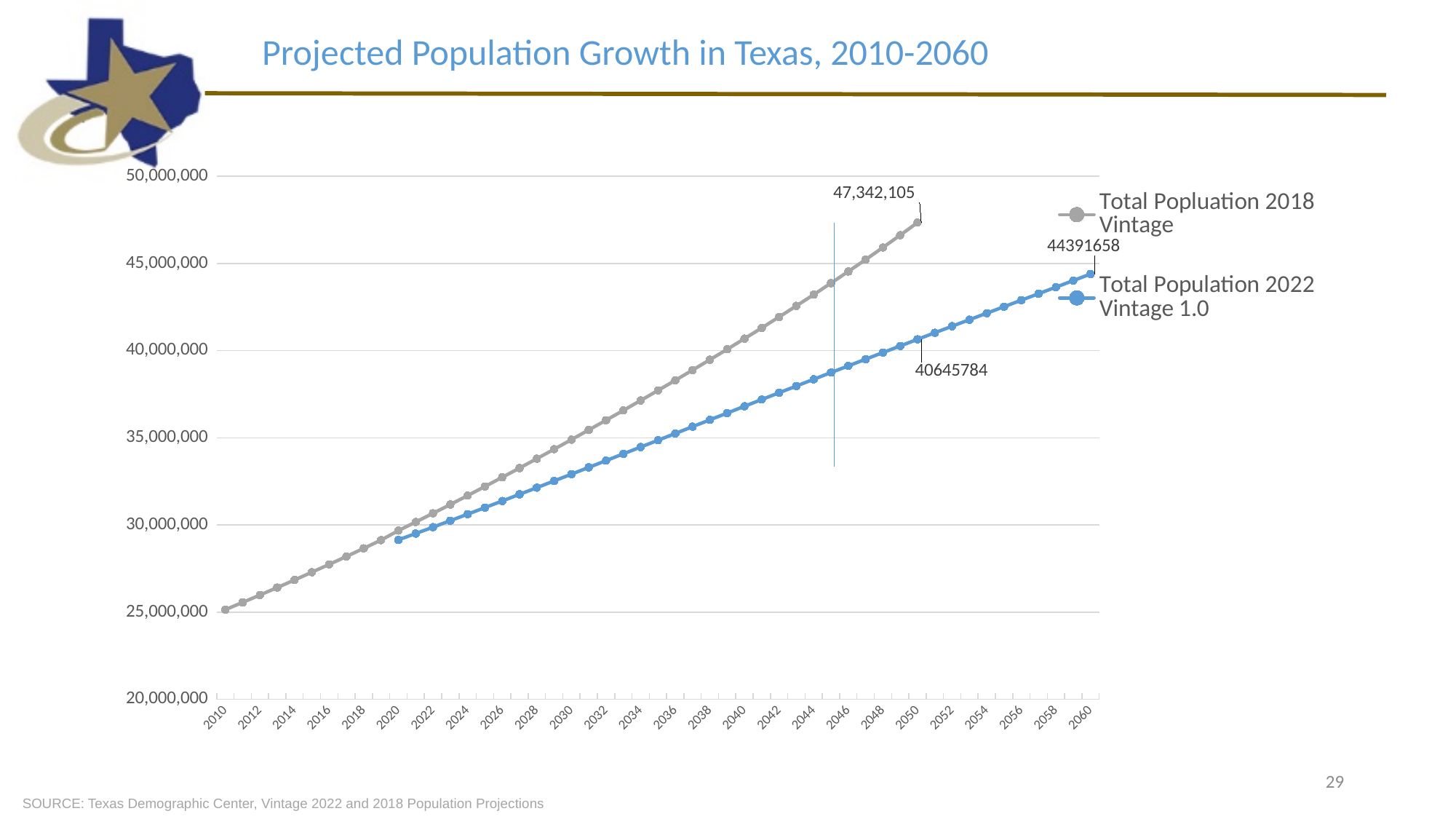
What is the value of the Total Population 2022 Vintage 1.0 series in 2050? 40645784 How many series does the legend list? 2 What is the value of the Total Population 2022 Vintage 1.0 series in 2060? 44391658 What is the title of the chart? Projected Population Growth in Texas, 2010-2060 What kind of chart is shown on the slide? line chart In 2050, which series has the higher projected population, the 2018 Vintage or the 2022 Vintage 1.0? Total Popluation 2018 Vintage Is the value for the Total Popluation 2018 Vintage series in 2030 greater or less than 30,000,000? greater What is the value of the Total Popluation 2018 Vintage series in 2050? 47,342,105 Is the value for the Total Population 2022 Vintage 1.0 series in 2040 greater or less than 35,000,000? greater Is the value for the Total Popluation 2018 Vintage series in 2010 greater or less than 30,000,000? less Do the values of the Total Population 2022 Vintage 1.0 series rise or fall from 2020 to 2060? rise What is the difference between the 2018 Vintage and 2022 Vintage 1.0 projections for 2050? 6,696,321